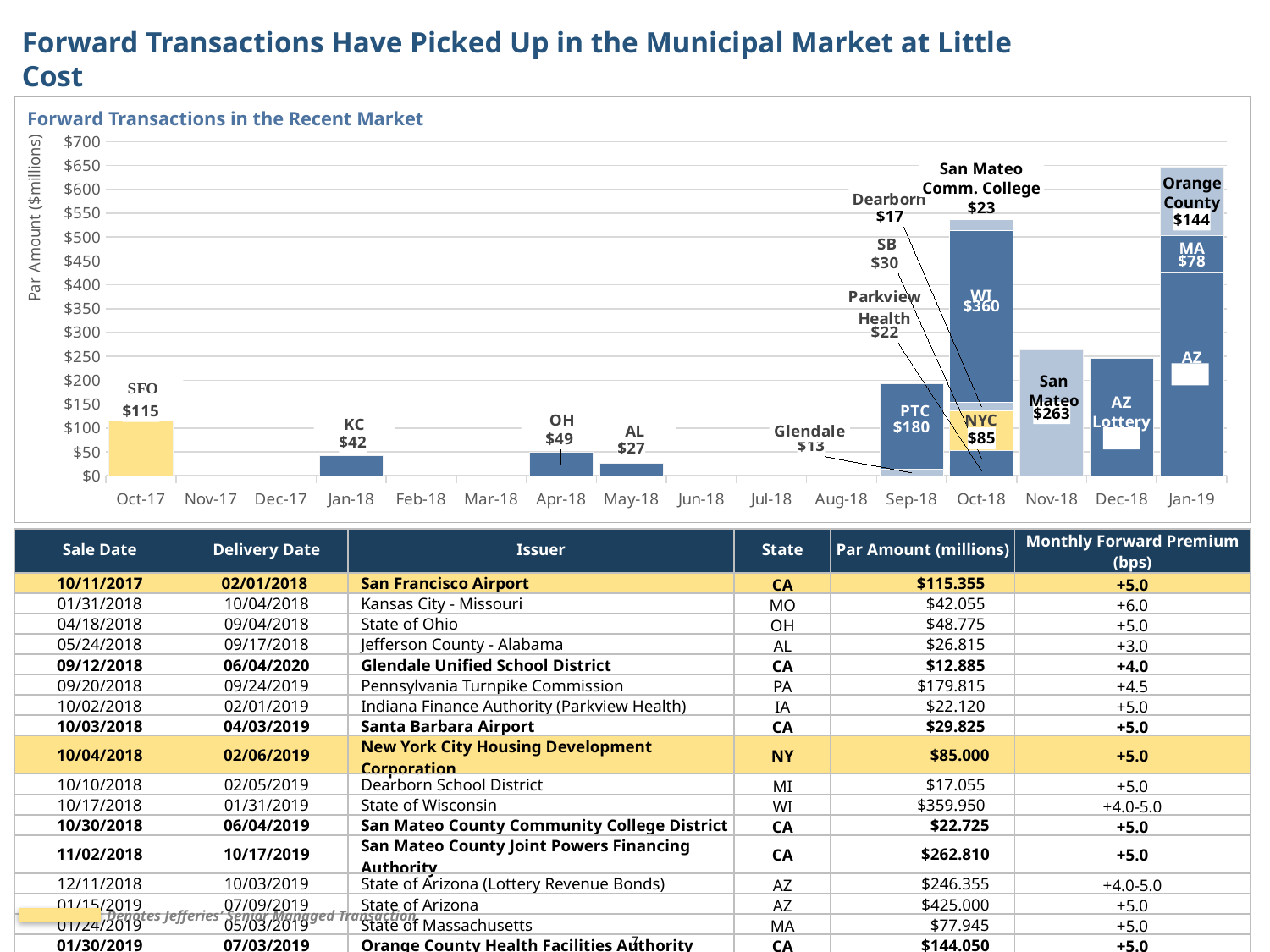
How many months are shown on the x axis of the chart? 16 Is the total height of the Jan-19 bar greater or less than $600? greater What is the value labeled for WI in the Oct-18 bar? $360 Which labeled transaction has the smallest value on the chart? Glendale Which is larger, the KC value in Jan-18 or the OH value in Apr-18? OH What is the value labeled for PTC in the Sep-18 bar? $180 Which month has the tallest bar in the chart? Jan-19 What is the value labeled for Orange County in the Jan-19 bar? $144 What is the y-axis title of the chart? Par Amount ($millions) What is the par amount shown for SFO in Oct-17? $115 What is the difference between the WI value and the NYC value in the Oct-18 bar? $275 What kind of chart is 'Forward Transactions in the Recent Market'? bar chart